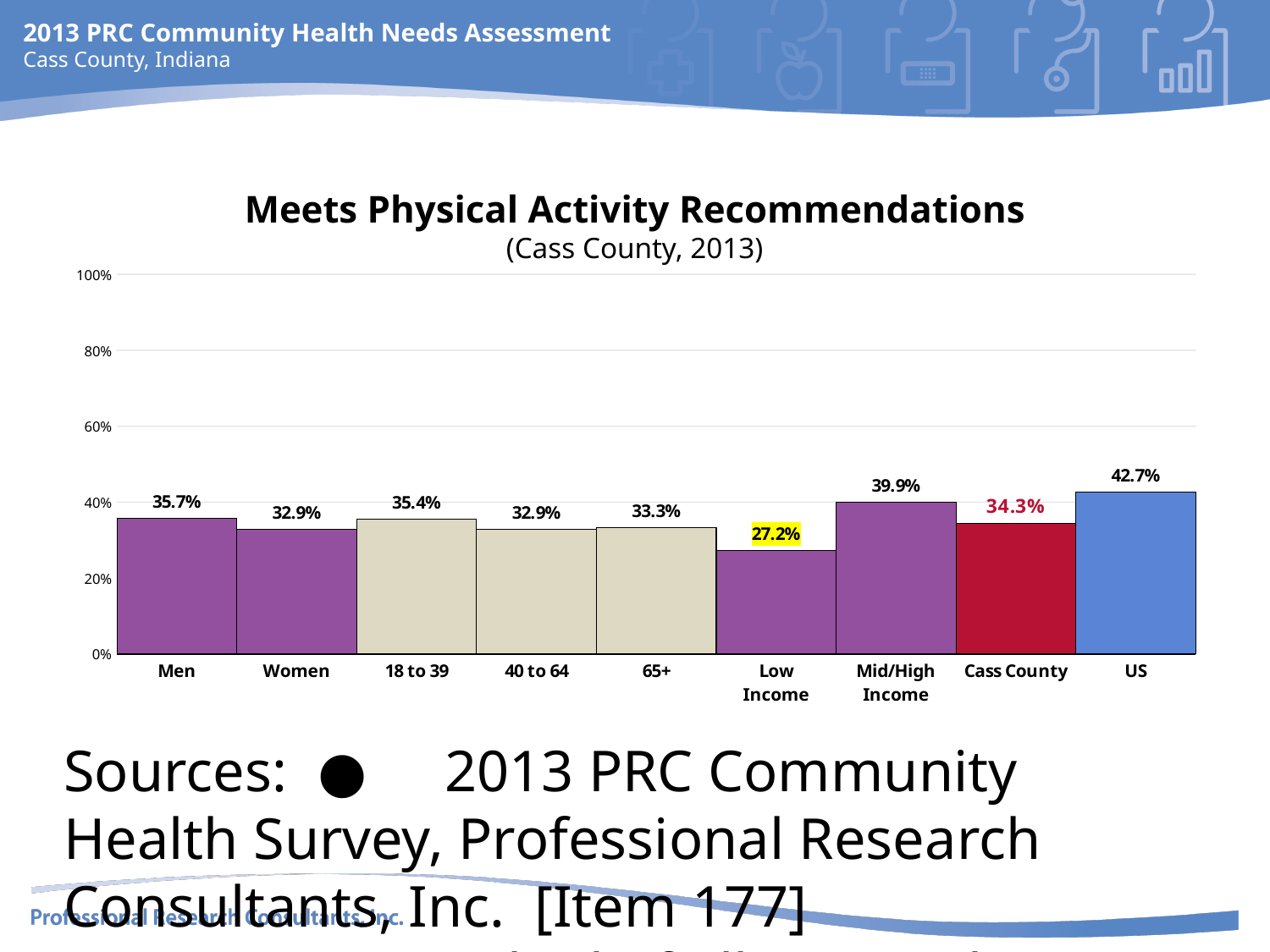
How many categories are shown on the x axis? 9 Is the value for 65+ greater or less than 40%? less What is the value for Low Income? 27.2% What is the value for Men? 35.7% Which category has the highest value? US What is the difference between the US value and the Cass County value? 8.4% Which is larger, the value for Mid/High Income or the value for Low Income? Mid/High Income What kind of chart is shown? bar chart What is the value for US? 42.7% Which category has the lowest value? Low Income What is the title of the chart? Meets Physical Activity Recommendations What is the value for Cass County? 34.3%